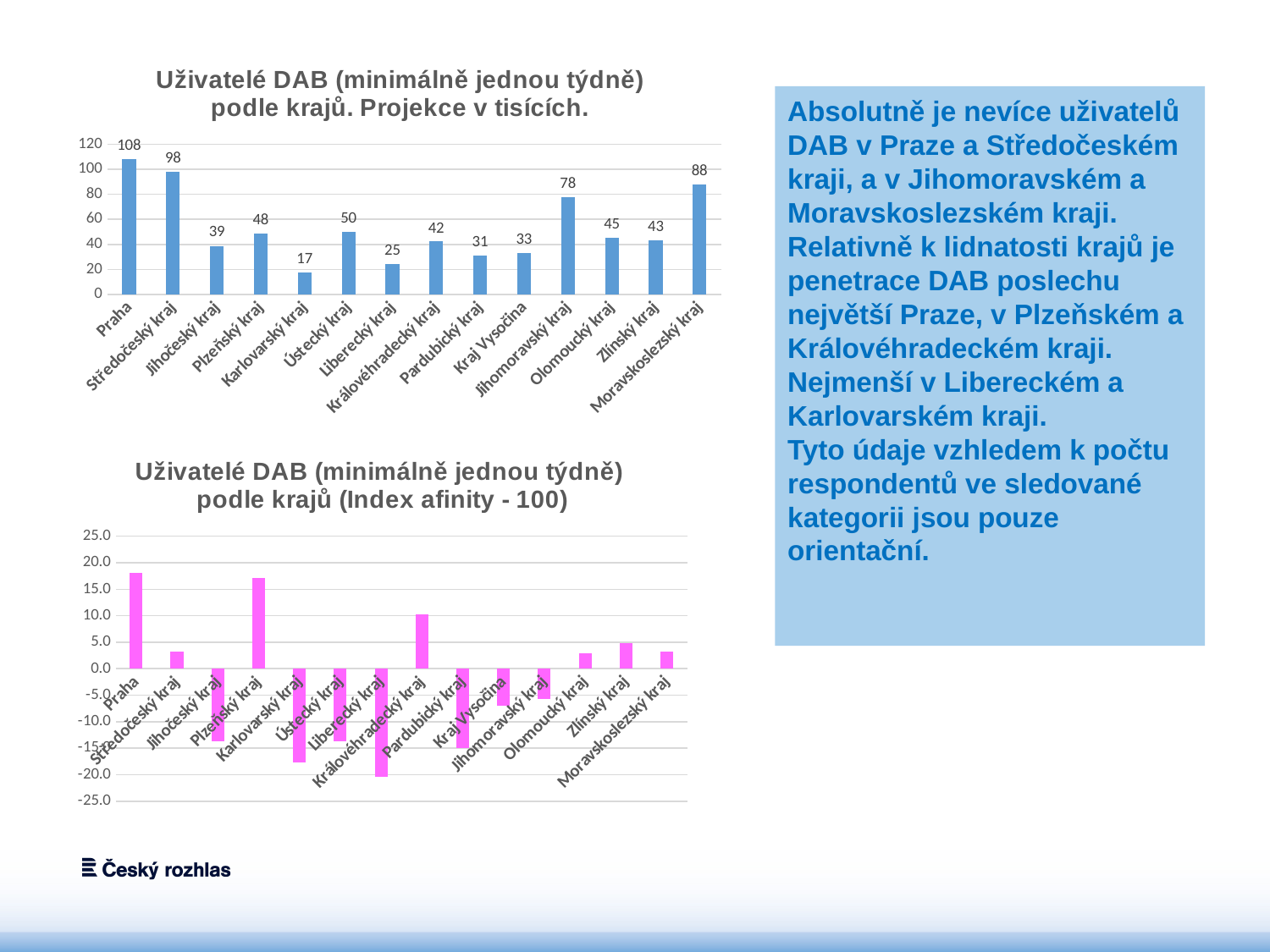
In the top chart (Projekce v tisících), which region has the lowest value? Karlovarský kraj In the top chart (Projekce v tisících), what is the value for Praha? 108 In the top chart (Projekce v tisících), what is the value for Karlovarský kraj? 17 In the top chart (Projekce v tisících), what is the value for Jihomoravský kraj? 78 In the bottom chart (Index afinity - 100), is the value for Liberecký kraj greater or less than -15.0? less In the bottom chart (Index afinity - 100), is the value for Praha greater or less than 15.0? greater In the top chart (Projekce v tisících), what is the difference between Praha and Středočeský kraj? 10 What kind of chart is the bottom chart (Index afinity - 100)? Bar chart In the top chart (Projekce v tisících), which is larger, Moravskoslezský kraj or Jihomoravský kraj? Moravskoslezský kraj How many regions are shown in the top chart (Projekce v tisících)? 14 In the bottom chart (Index afinity - 100), which is larger, Praha or Královéhradecký kraj? Praha In the top chart (Projekce v tisících), which region has the highest value? Praha